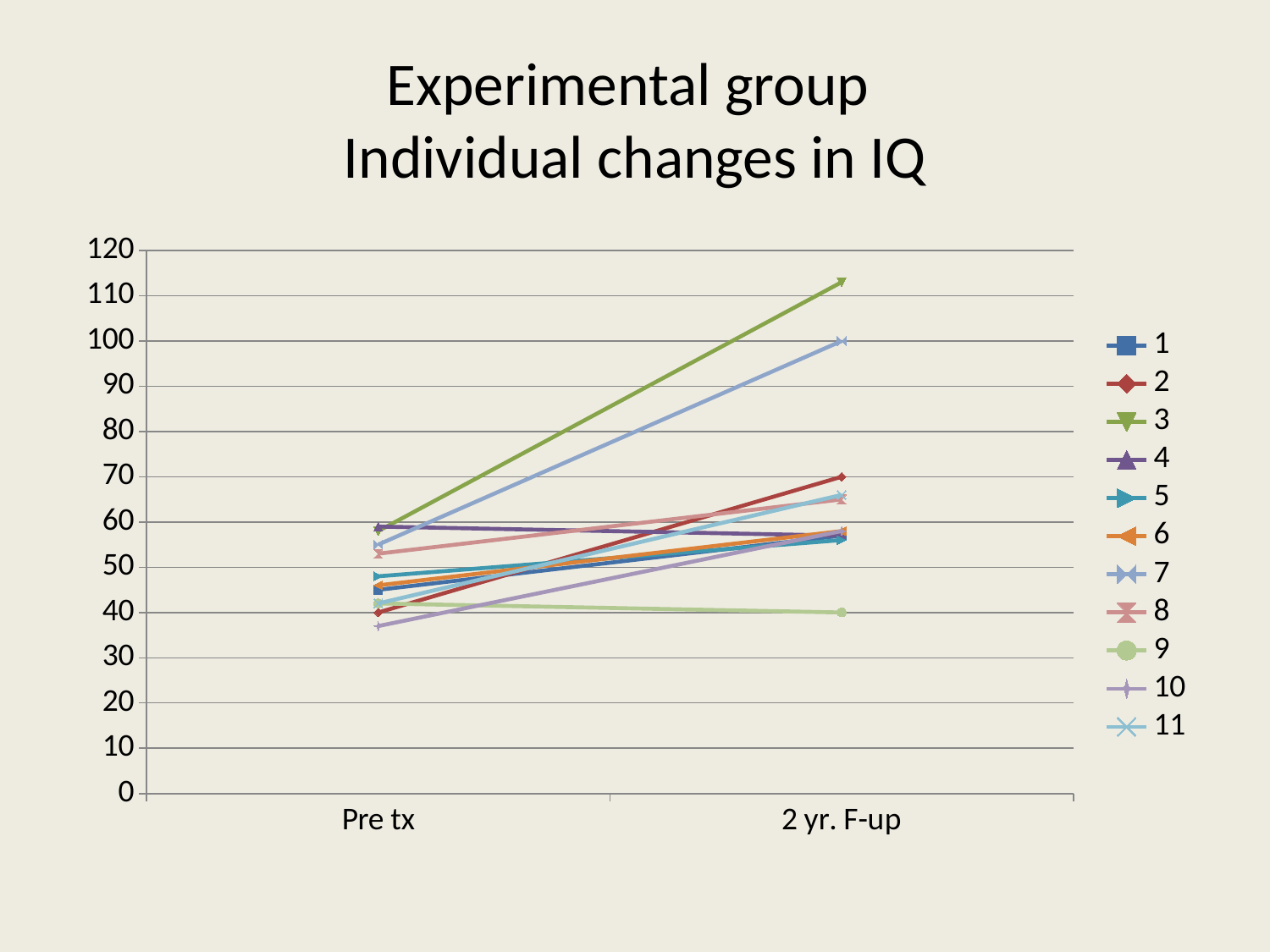
Does the value for series 9 rise or fall from Pre tx to 2 yr. F-up? fall What kind of chart is shown on the slide? line chart At 2 yr. F-up, which is larger: the value for series 3 or series 7? 3 Is the value for series 10 at Pre tx greater or less than 40? less Which series has the highest value at 2 yr. F-up? 3 Which series has the lowest value at 2 yr. F-up? 9 How many series does the legend list? 11 Is the value for series 3 at 2 yr. F-up greater or less than 100? greater What is the value for series 7 at 2 yr. F-up? 100 What is the title of the chart? Experimental group Individual changes in IQ Does the value for series 3 rise or fall from Pre tx to 2 yr. F-up? rise How many time points are shown on the x axis? 2